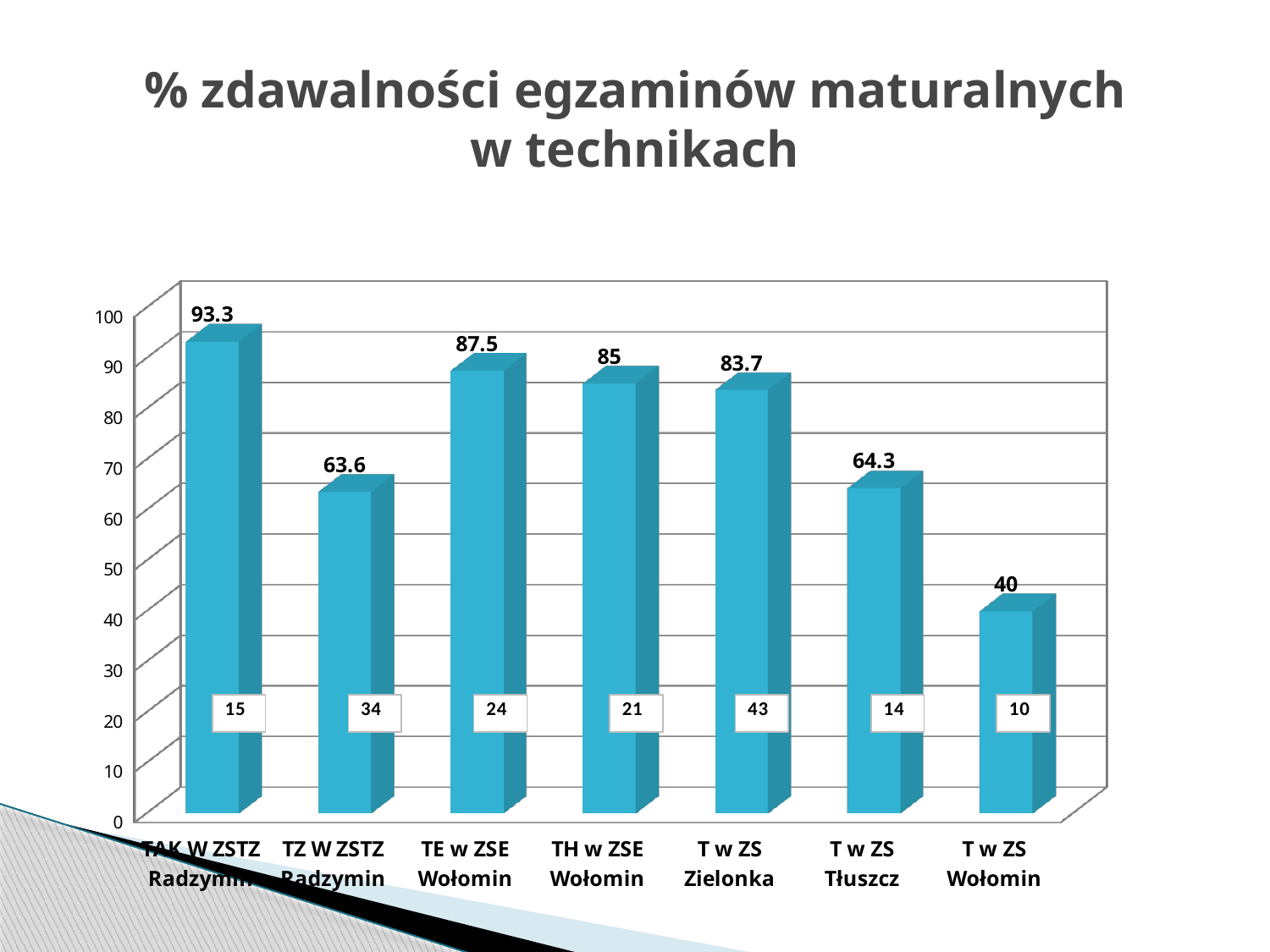
Which category has the lowest value? T w ZS Wołomin Is the value for TH w ZSE Wołomin greater or less than 80? greater What is the value for T w ZS Zielonka? 83.7 What is the title of the chart? % zdawalności egzaminów maturalnych w technikach What is the value for T w ZS Tłuszcz? 64.3 What kind of chart is shown on the slide? bar chart How many categories are shown on the chart? 7 What is the value for T w ZS Wołomin? 40 What is the difference between the values for TH w ZSE Wołomin and T w ZS Wołomin? 45 What is the value for TE w ZSE Wołomin? 87.5 Which category has the highest value? TAK W ZSTZ Radzymin Which is larger, the value for TZ W ZSTZ Radzymin or the value for T w ZS Tłuszcz? T w ZS Tłuszcz